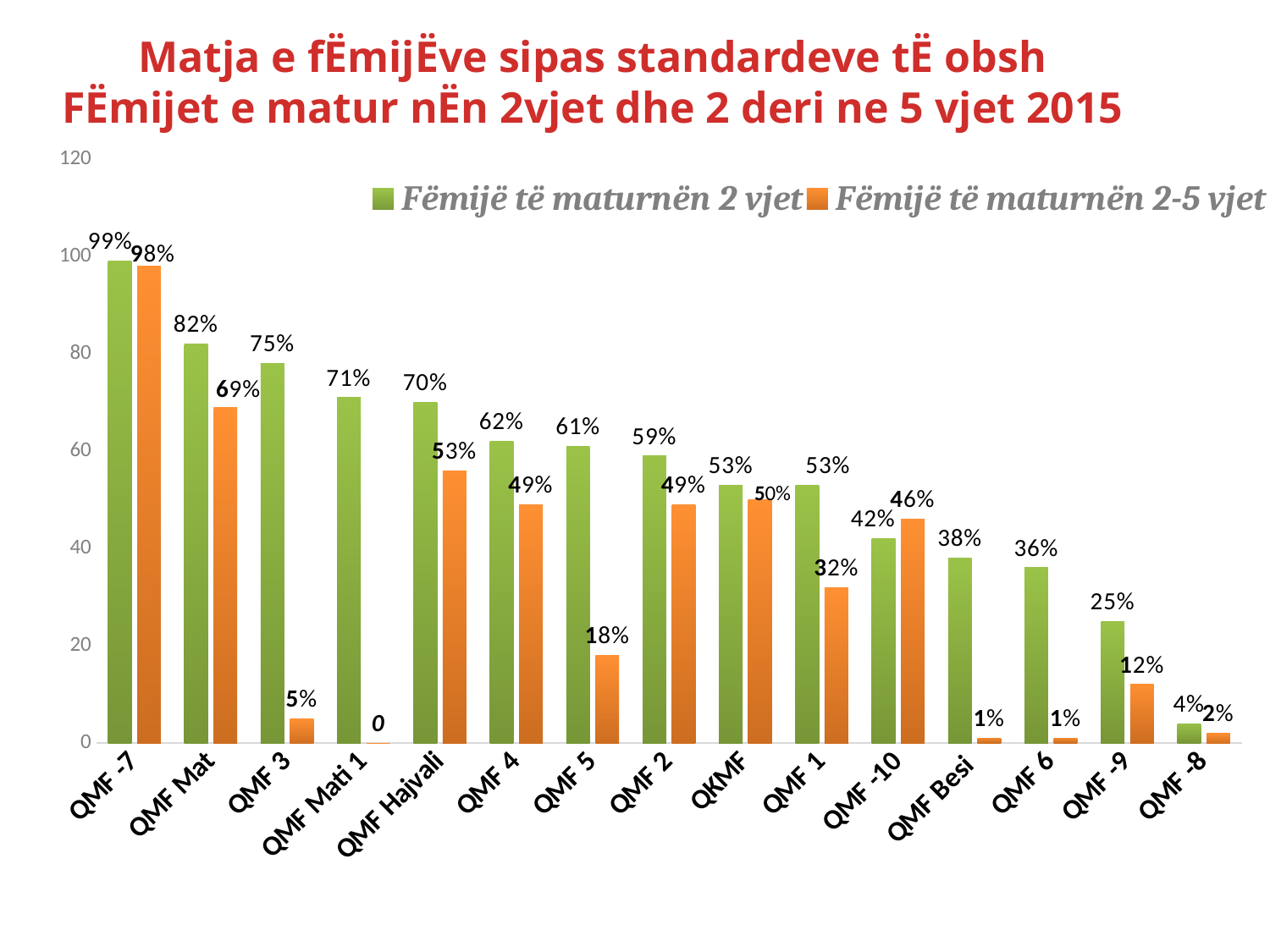
Which category has the lowest value in the 'Fëmijë të maturnën 2 vjet' series? QMF -8 Do the 'Fëmijë të maturnën 2 vjet' values generally rise or fall from left to right along the x axis? Fall Which category has the highest value in the 'Fëmijë të maturnën 2 vjet' series? QMF -7 How many categories are shown on the x axis? 15 How many series does the legend list? 2 What is the value for QMF -10 in the 'Fëmijë të maturnën 2-5 vjet' series? 46% Which is larger for QMF -10: the 'Fëmijë të maturnën 2 vjet' value or the 'Fëmijë të maturnën 2-5 vjet' value? Fëmijë të maturnën 2-5 vjet What colour are the bars for the 'Fëmijë të maturnën 2-5 vjet' series? Orange What kind of chart is shown on the slide? Bar chart What is the value for QMF Hajvali in the 'Fëmijë të maturnën 2 vjet' series? 70% What is the difference between the 'Fëmijë të maturnën 2 vjet' and 'Fëmijë të maturnën 2-5 vjet' values for QMF 3? 70% What is the value for QMF 5 in the 'Fëmijë të maturnën 2-5 vjet' series? 18%